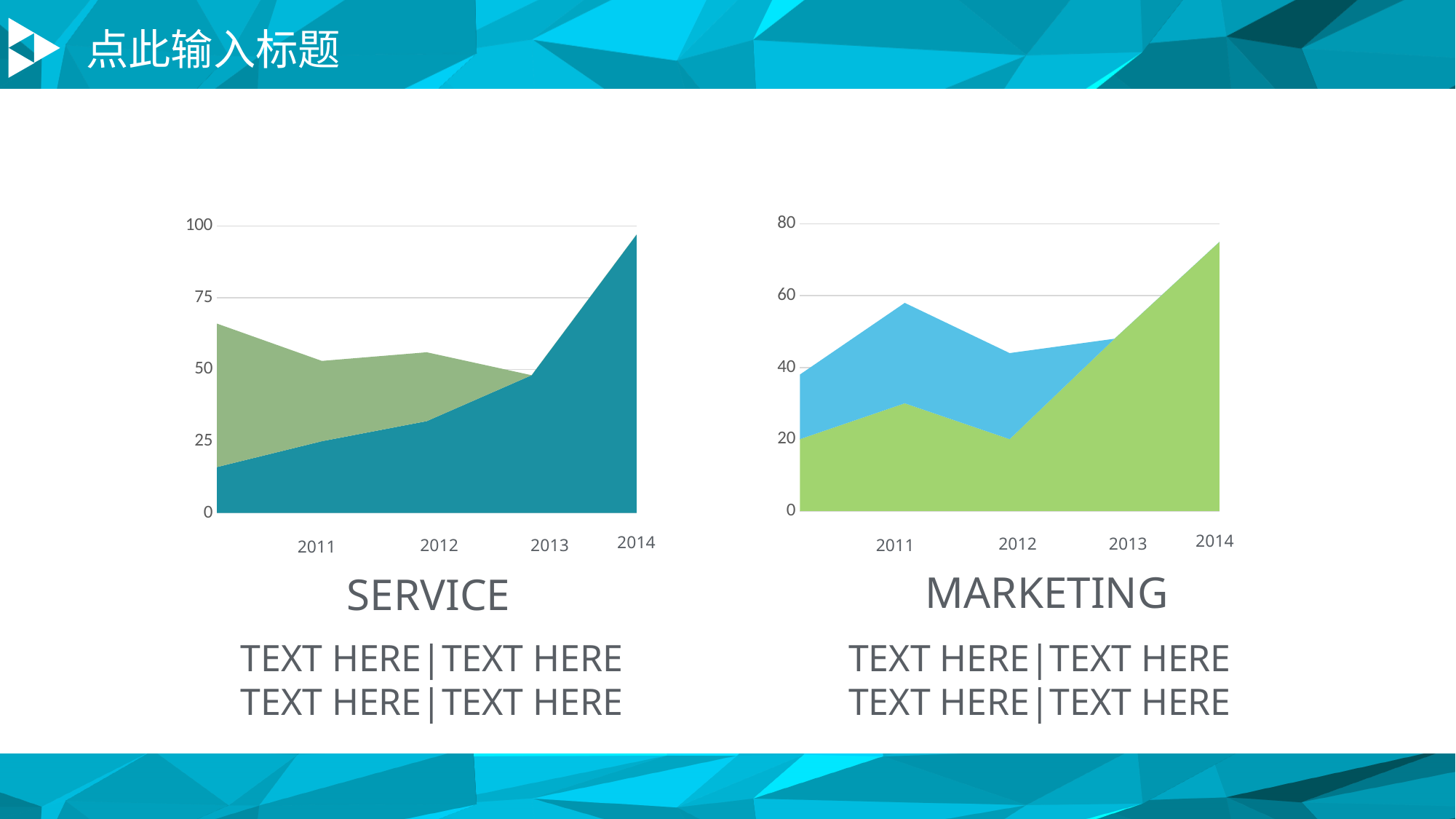
What kind of chart is the MARKETING chart on the right? area chart What kind of chart is the SERVICE chart on the left? area chart In the MARKETING chart, which year has the highest value for the blue series? 2011 In the MARKETING chart, is the value of the green series in 2014 greater or less than 60? greater What is the highest value shown on the y axis of the MARKETING chart? 80 In the SERVICE chart, does the dark teal series rise or fall from 2011 to 2014? rise In the MARKETING chart, which series is higher in 2014, the blue series or the green series? the green series In the SERVICE chart, which series is higher in 2011, the green series or the dark teal series? the green series In the SERVICE chart, which year has the highest value for the dark teal series? 2014 In the SERVICE chart, is the value of the dark teal series in 2014 greater or less than 75? greater How many years are shown on the x axis of the SERVICE chart? 4